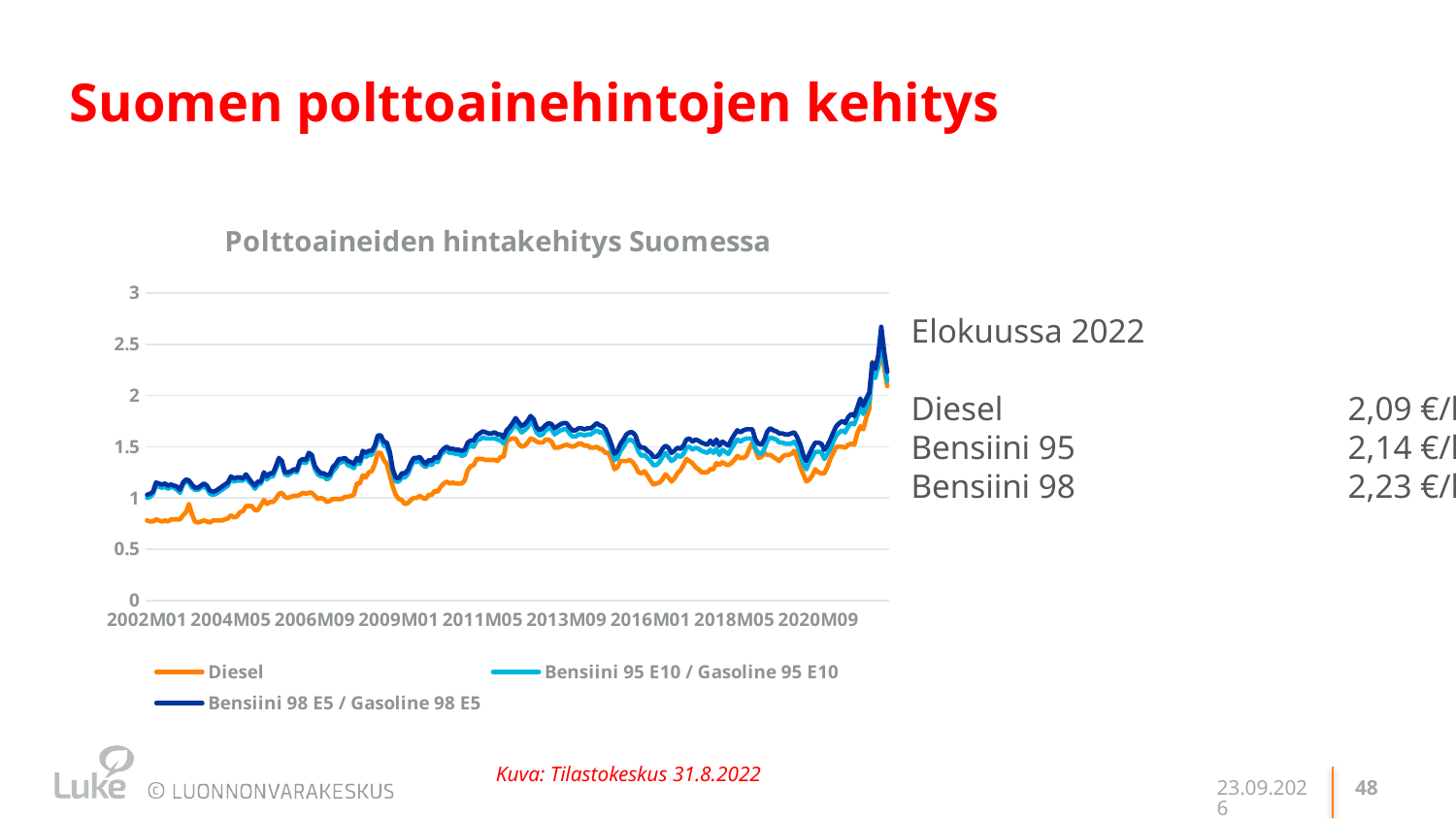
Which of the three fuels listed for August 2022 has the lowest price? Diesel How many labelled tick marks are shown on the x axis of the chart? 9 According to the slide, what was the price of Bensiini 98 in August 2022? 2,23 €/l Do the fuel prices in the chart generally rise or fall from 2002M01 to the end of the series? rise What is the title of the chart? Polttoaineiden hintakehitys Suomessa How many series does the chart legend list? 3 Which colour is used for the Diesel line in the chart? orange Which of the three fuels listed for August 2022 has the highest price? Bensiini 98 What is the difference between the August 2022 prices of Bensiini 98 and Diesel? 0,14 €/l According to the slide, what was the price of Diesel in August 2022 (Elokuussa 2022)? 2,09 €/l What kind of chart is shown on the slide? line chart Is the Diesel value at 2002M01 greater or less than 1? less